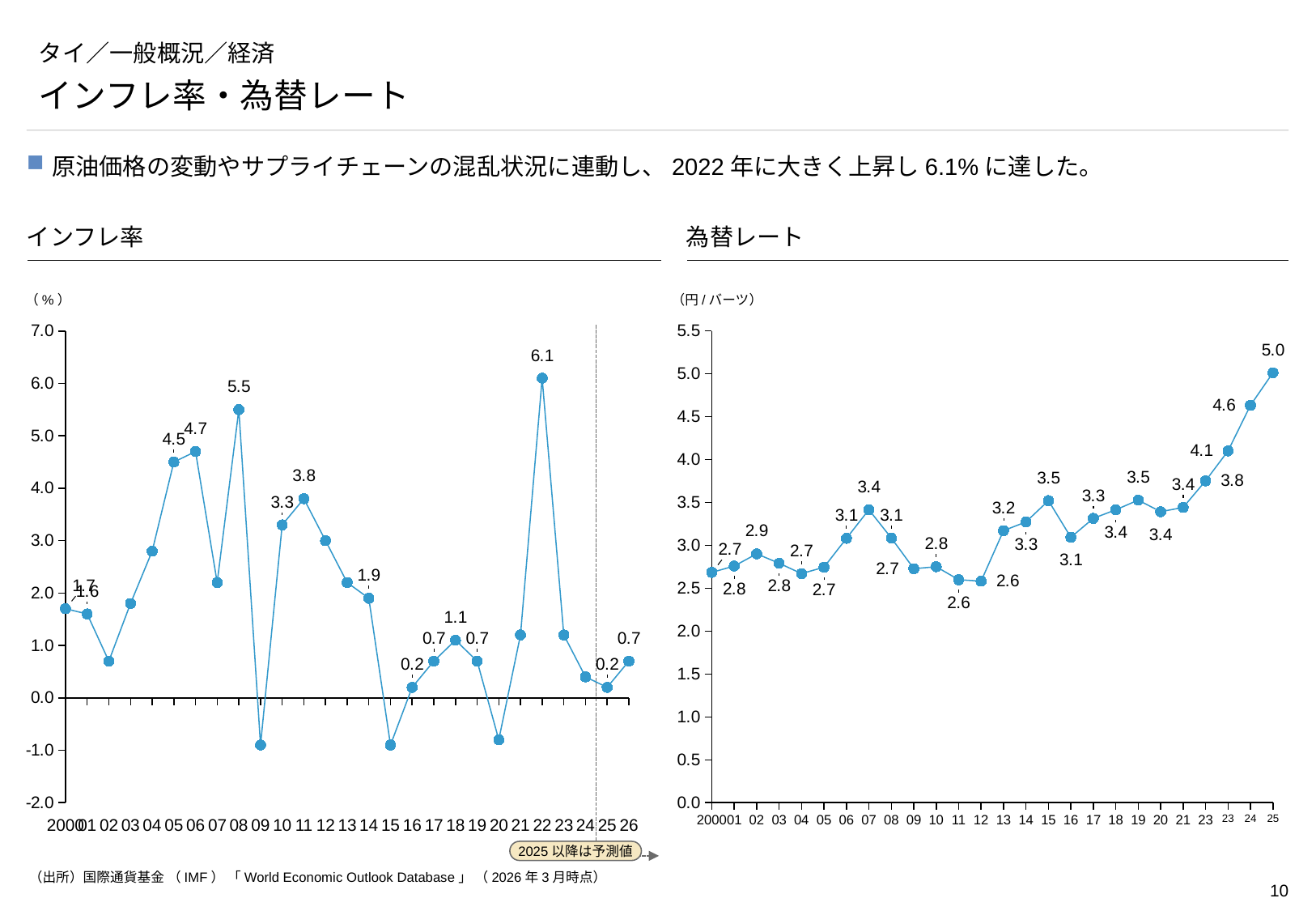
On the インフレ率 chart, is the value for 2009 greater or less than 0.0? less On the インフレ率 chart, which year has the highest inflation rate? 2022 On the 為替レート chart, what is the value for 2025? 5.0 On the インフレ率 chart, what is the inflation rate for 2022? 6.1 On the 為替レート chart, which is larger, the value for 2015 or the value for 2016? 2015 On the インフレ率 chart, what is the difference between the 2022 value and the 2008 value? 0.6 What type of chart is the インフレ率 chart? line chart On the 為替レート chart, what is the difference between the 2025 value and the 2024 value? 0.4 On the 為替レート chart, what is the value for 2007? 3.4 On the 為替レート chart, which year has the highest value? 2025 On the インフレ率 chart, what is the value for 2008? 5.5 On the インフレ率 chart, what is the value shown for 2026? 0.7